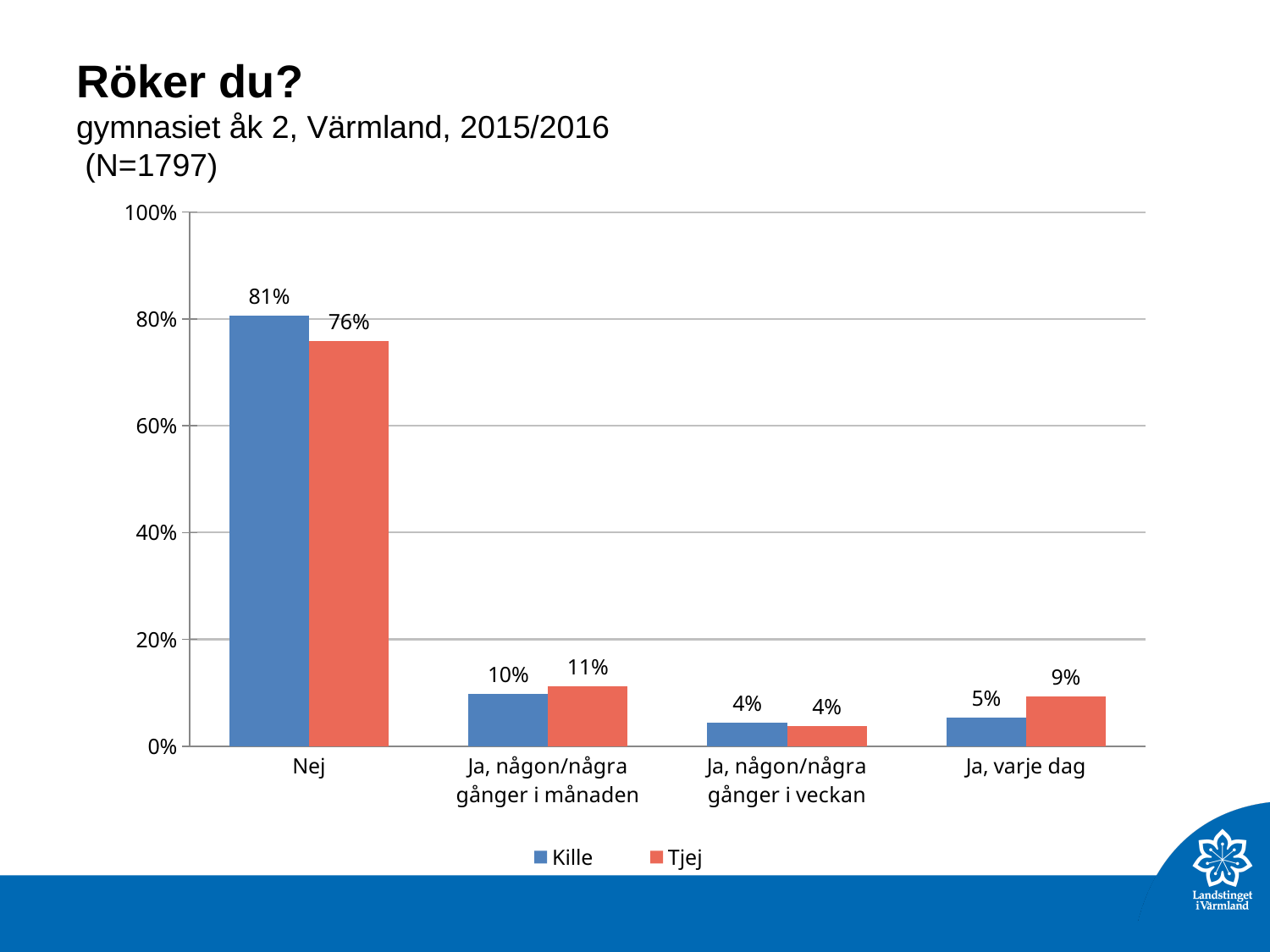
Which category has the lowest value for Tjej? Ja, någon/några gånger i veckan What is the value for Kille in the Nej category? 81% How many categories are shown on the x axis? 4 What is the value for Tjej in the 'Ja, varje dag' category? 9% What is the value for Tjej in the Nej category? 76% What is the difference between the Kille and Tjej values in the Nej category? 5% Is the value for Tjej in the Nej category greater or less than 60%? greater What kind of chart is shown on the slide? Bar chart In the 'Ja, varje dag' category, which series has the larger value, Kille or Tjej? Tjej Which category has the highest value for Kille? Nej What is the value for Kille in the 'Ja, någon/några gånger i månaden' category? 10% How many series does the legend list? 2